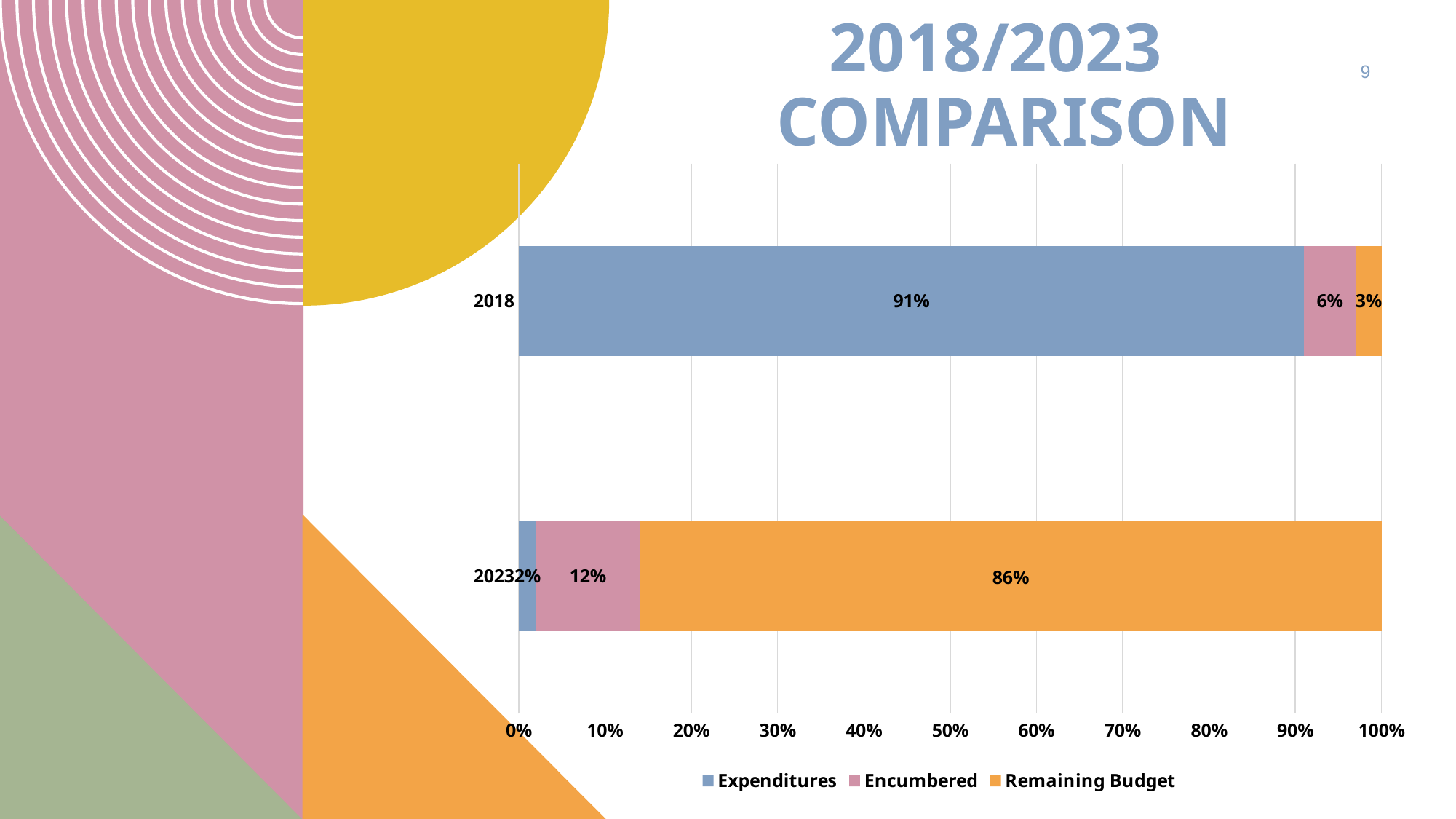
What kind of chart is shown on the slide? Stacked bar chart How many years are shown on the chart? 2 What is the Remaining Budget value for 2018? 3% Which year has the higher Remaining Budget share, 2018 or 2023? 2023 What is the Remaining Budget value for 2023? 86% What is the difference between the Remaining Budget values for 2023 and 2018? 83% What is the Encumbered value for 2023? 12% What is the Expenditures value for 2018? 91% How many series does the legend list? 3 Which year has the higher Expenditures share, 2018 or 2023? 2018 What is the Encumbered value for 2018? 6% What is the difference between the Encumbered values for 2023 and 2018? 6%